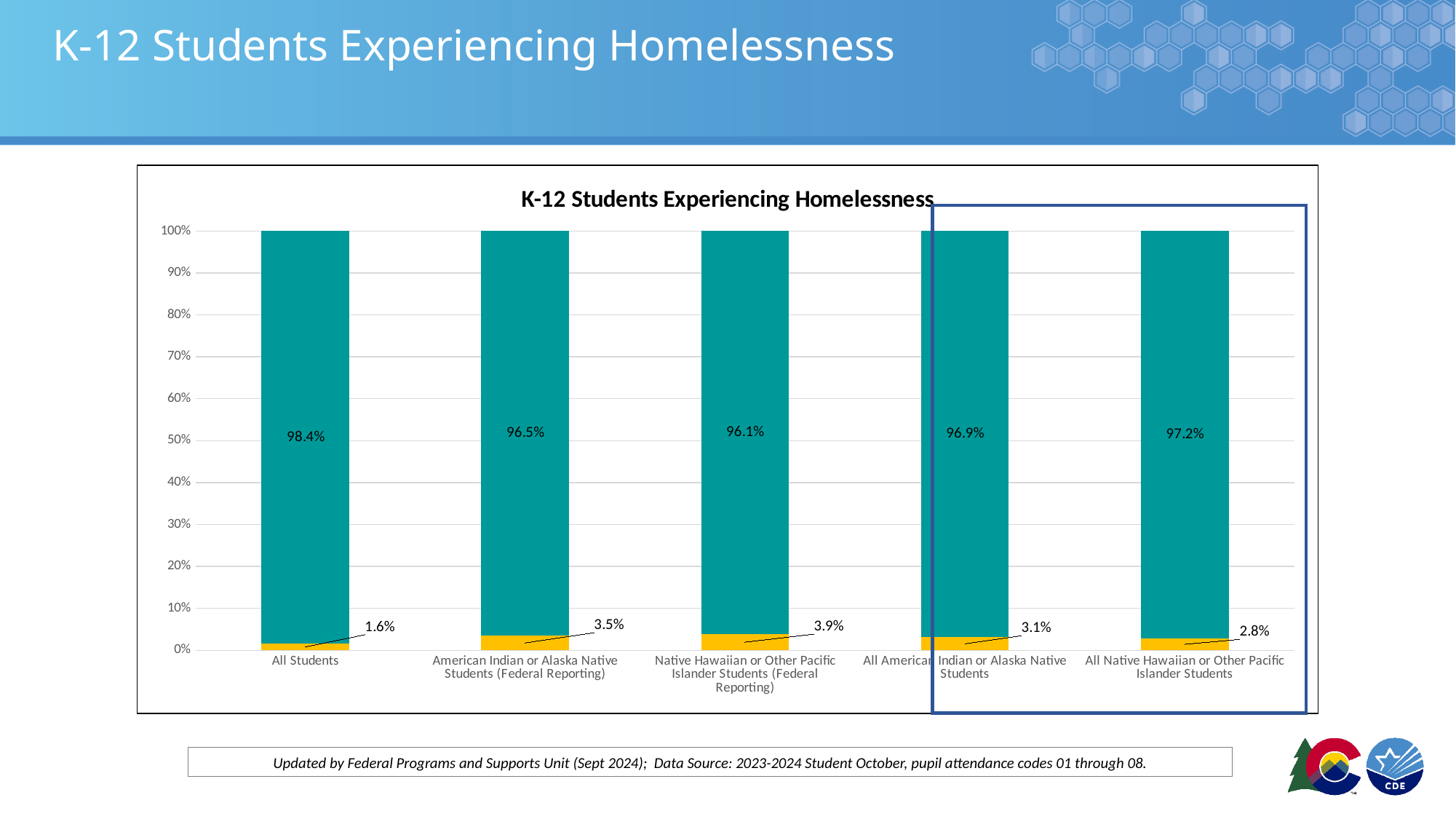
What is the value of the teal (upper) segment for Native Hawaiian or Other Pacific Islander Students (Federal Reporting)? 96.1% How many categories are shown on the x axis of the chart? 5 Which category has the lowest value for the yellow (lower) segment? All Students What is the total of the stacked bar for American Indian or Alaska Native Students (Federal Reporting)? 100% What is the value of the yellow (lower) segment for All Students? 1.6% Which is larger: the yellow segment for All American Indian or Alaska Native Students or for All Native Hawaiian or Other Pacific Islander Students? All American Indian or Alaska Native Students What kind of chart is shown on the slide? stacked bar chart What is the difference between the yellow segment values for American Indian or Alaska Native Students (Federal Reporting) and All Students? 1.9% What is the value of the teal (upper) segment for All Native Hawaiian or Other Pacific Islander Students? 97.2% Which category has the highest value for the yellow (lower) segment? Native Hawaiian or Other Pacific Islander Students (Federal Reporting) What is the chart's title? K-12 Students Experiencing Homelessness What is the value of the yellow (lower) segment for All American Indian or Alaska Native Students? 3.1%